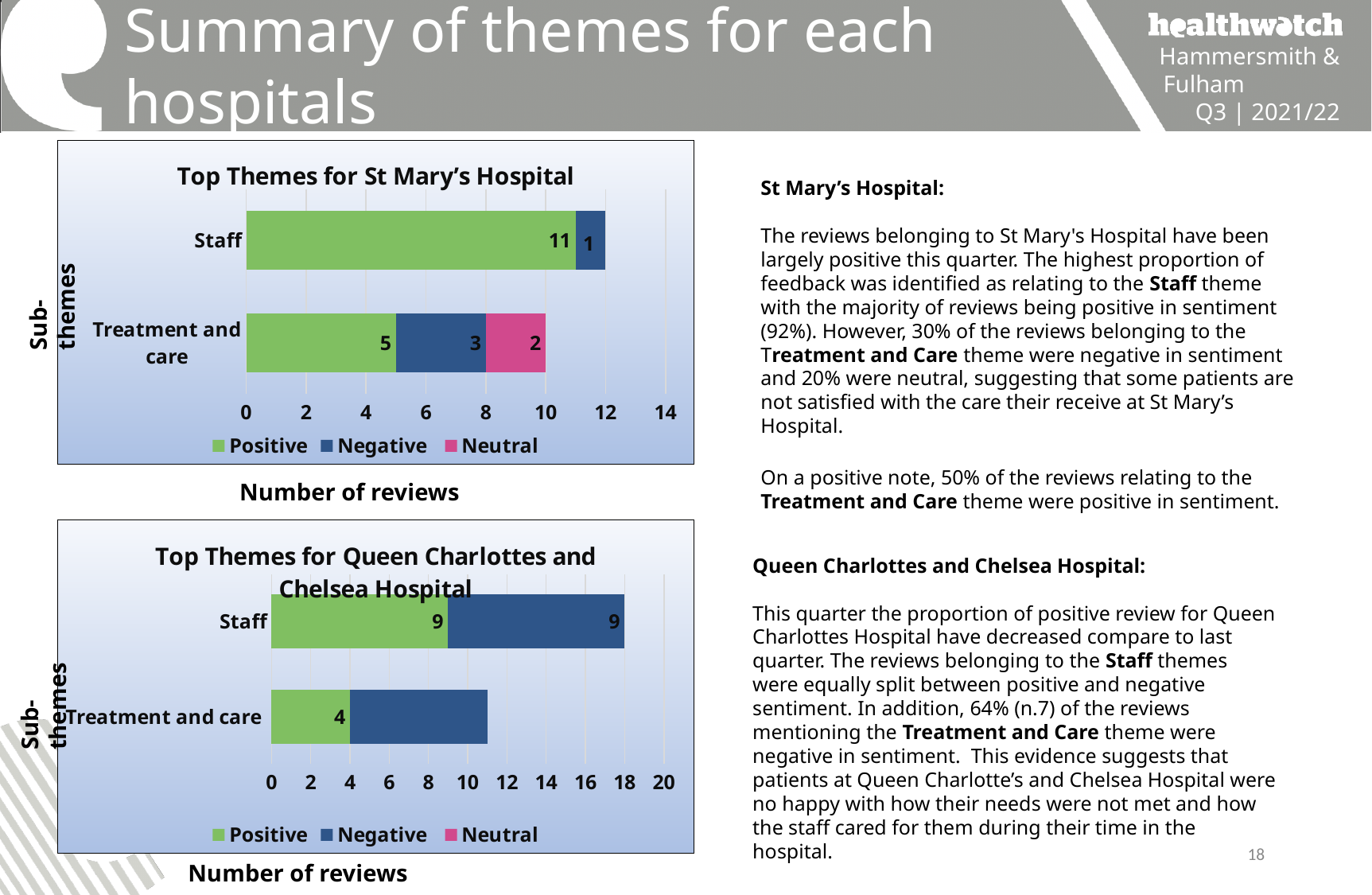
How many series does the legend list in the 'Top Themes for St Mary's Hospital' chart? 3 In the 'Top Themes for Queen Charlottes and Chelsea Hospital' chart, how many positive reviews are shown for Treatment and care? 4 In the 'Top Themes for St Mary's Hospital' chart, which sub-theme has more positive reviews, Staff or Treatment and care? Staff In the 'Top Themes for St Mary's Hospital' chart, what is the total number of reviews for Treatment and care? 10 In the 'Top Themes for St Mary's Hospital' chart, how many positive reviews are shown for Staff? 11 In the 'Top Themes for Queen Charlottes and Chelsea Hospital' chart, how many negative reviews are shown for Staff? 9 What kind of chart is the 'Top Themes for Queen Charlottes and Chelsea Hospital' chart? Stacked bar chart In the 'Top Themes for St Mary's Hospital' chart, what is the difference between positive and negative reviews for Treatment and care? 2 In the 'Top Themes for Queen Charlottes and Chelsea Hospital' chart, what is the total number of reviews for Staff? 18 In the 'Top Themes for St Mary's Hospital' chart, how many neutral reviews are shown for Treatment and care? 2 In the 'Top Themes for Queen Charlottes and Chelsea Hospital' chart, is the total length of the Treatment and care bar greater or less than 10? greater In the 'Top Themes for St Mary's Hospital' chart, what is the total number of reviews for Staff? 12